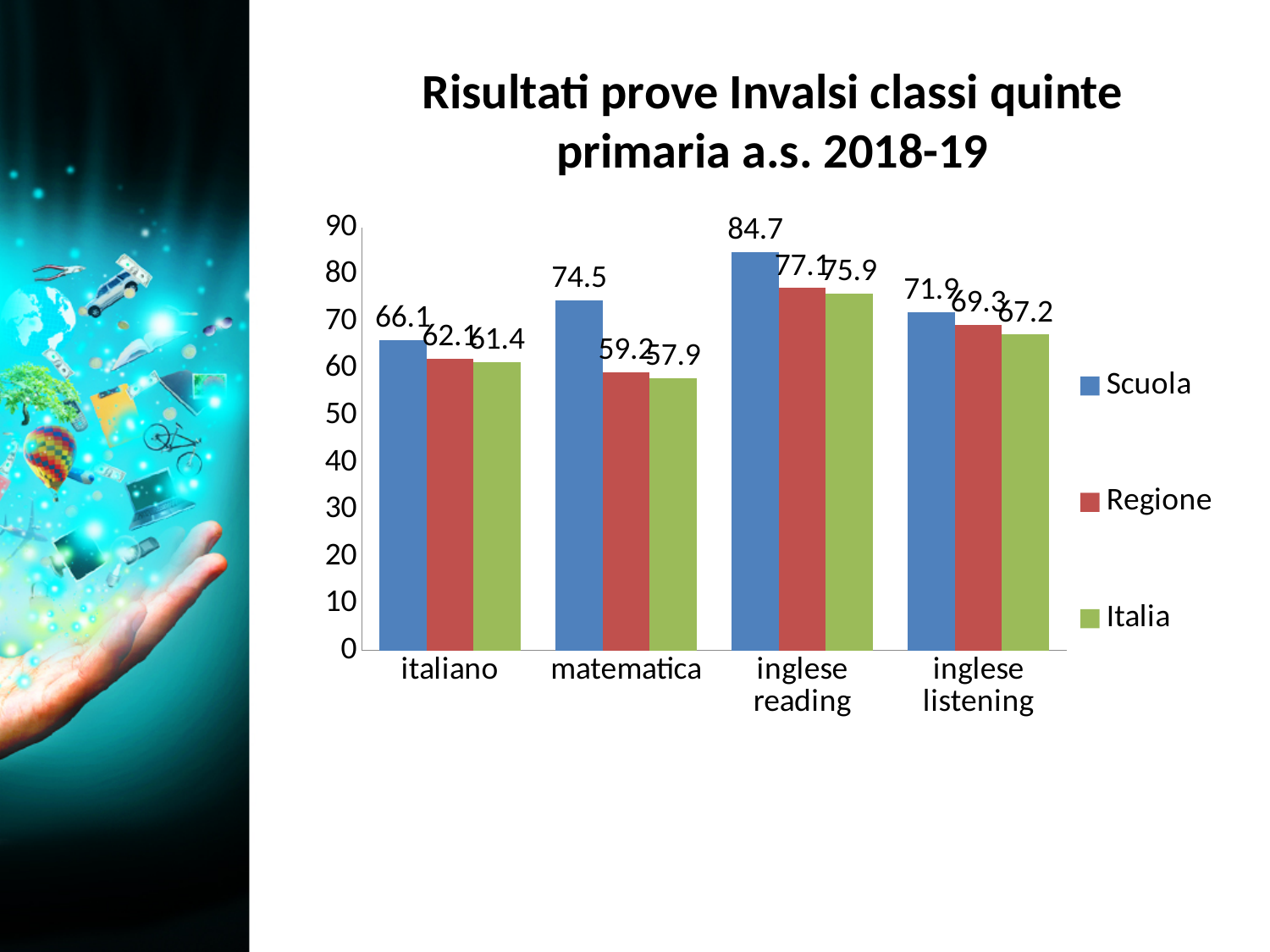
In which category does the Scuola series reach its highest value? inglese reading In the italiano category, which is larger: the Scuola value or the Regione value? Scuola What is the value for Scuola in the italiano category? 66.1 In which category does the Italia series have its lowest value? matematica Is the value for Italia in the inglese reading category greater or less than 70? greater How many categories are shown on the x axis? 4 How many series does the legend list? 3 What is the value for Scuola in the matematica category? 74.5 What is the value for Regione in the inglese listening category? 69.3 What kind of chart is shown on the slide? bar chart What is the value for Scuola in the inglese reading category? 84.7 What is the difference between the Scuola and Regione values in the matematica category? 15.3